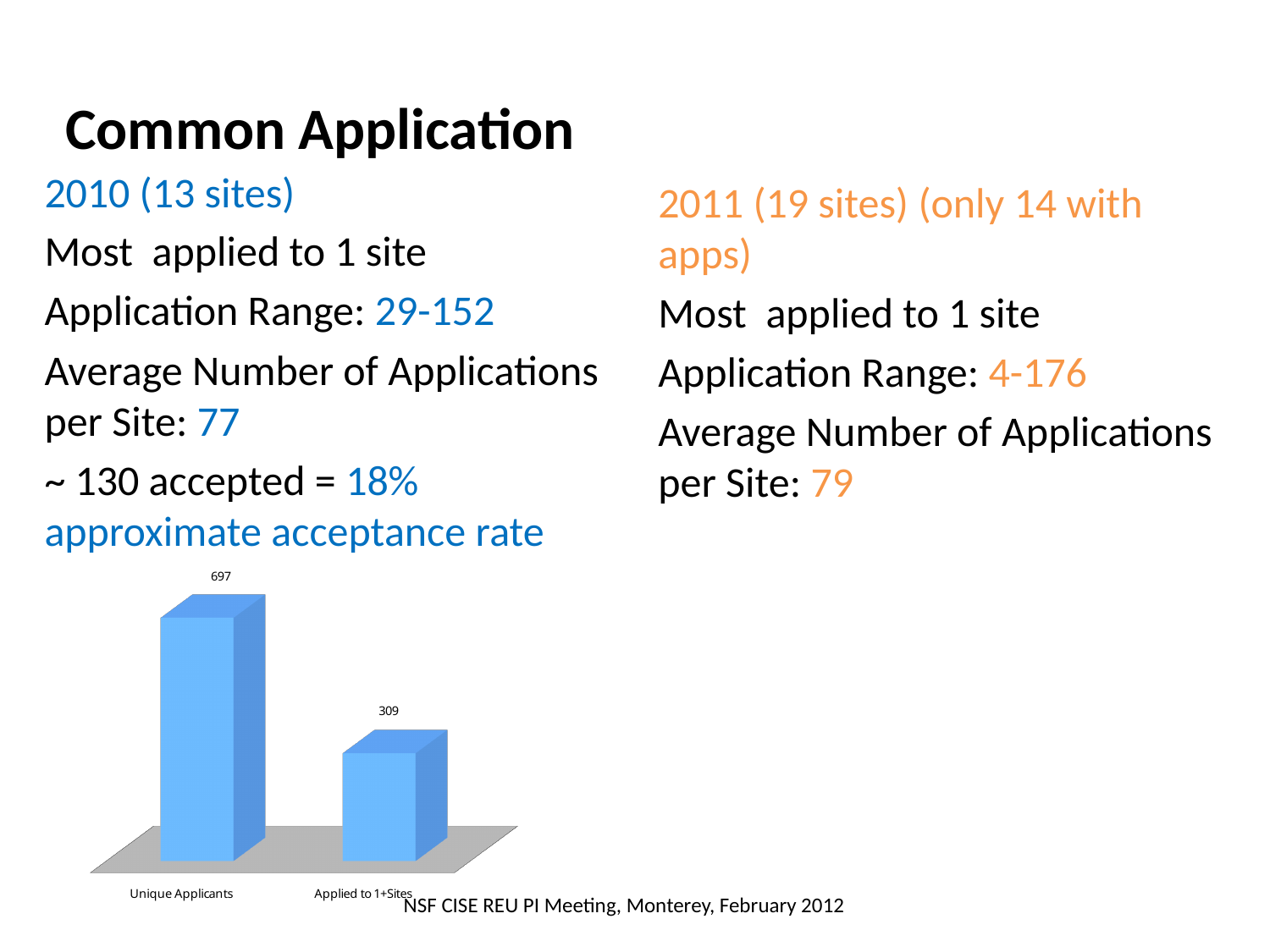
What kind of chart is shown on the slide? bar chart How many categories are shown in the chart? 2 Which is larger, Unique Applicants or Applied to 1+Sites? Unique Applicants Which category has the highest value? Unique Applicants What is the difference between Unique Applicants and Applied to 1+Sites? 388 What is the value for Unique Applicants? 697 What colour are the bars in the chart? blue Do the values rise or fall from left to right across the chart? fall What is the value for Applied to 1+Sites? 309 Which category has the lowest value? Applied to 1+Sites